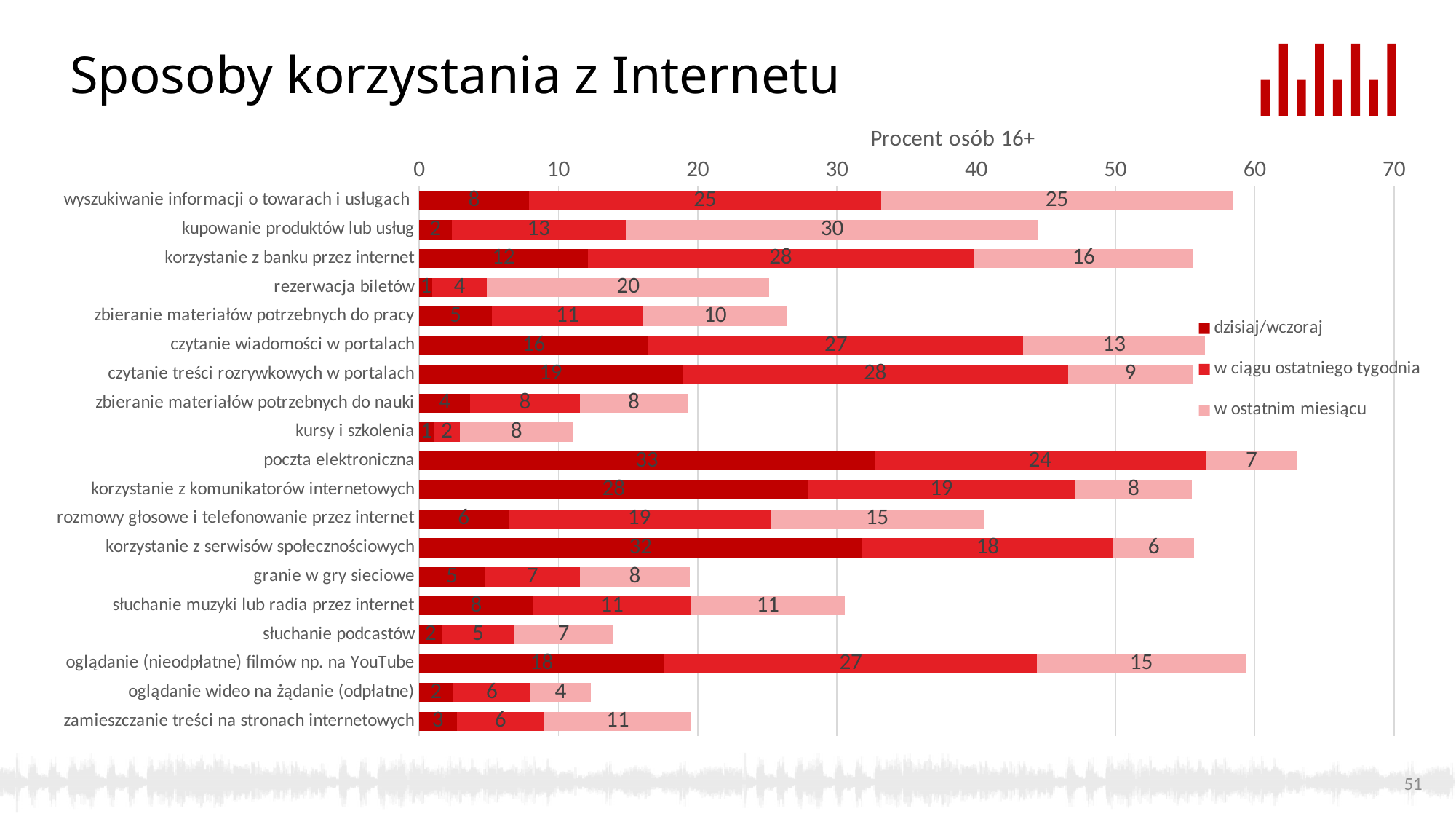
What kind of chart is shown on the slide? stacked bar chart What is the value of 'dzisiaj/wczoraj' for 'poczta elektroniczna'? 33 What is the total of the stacked bar for 'słuchanie podcastów'? 14 What is the title of the horizontal axis? Procent osób 16+ How many categories are plotted on the chart? 19 What is the value of 'w ciągu ostatniego tygodnia' for 'korzystanie z banku przez internet'? 28 What is the difference between the 'w ciągu ostatniego tygodnia' values for 'czytanie wiadomości w portalach' and 'granie w gry sieciowe'? 20 How many series does the legend list? 3 What is the value of 'w ostatnim miesiącu' for 'kupowanie produktów lub usług'? 30 Which is larger: the 'dzisiaj/wczoraj' value for 'korzystanie z komunikatorów internetowych' or for 'oglądanie (nieodpłatne) filmów np. na YouTube'? korzystanie z komunikatorów internetowych Which category has the highest value for 'dzisiaj/wczoraj'? poczta elektroniczna Which category has the highest value for 'w ostatnim miesiącu'? kupowanie produktów lub usług